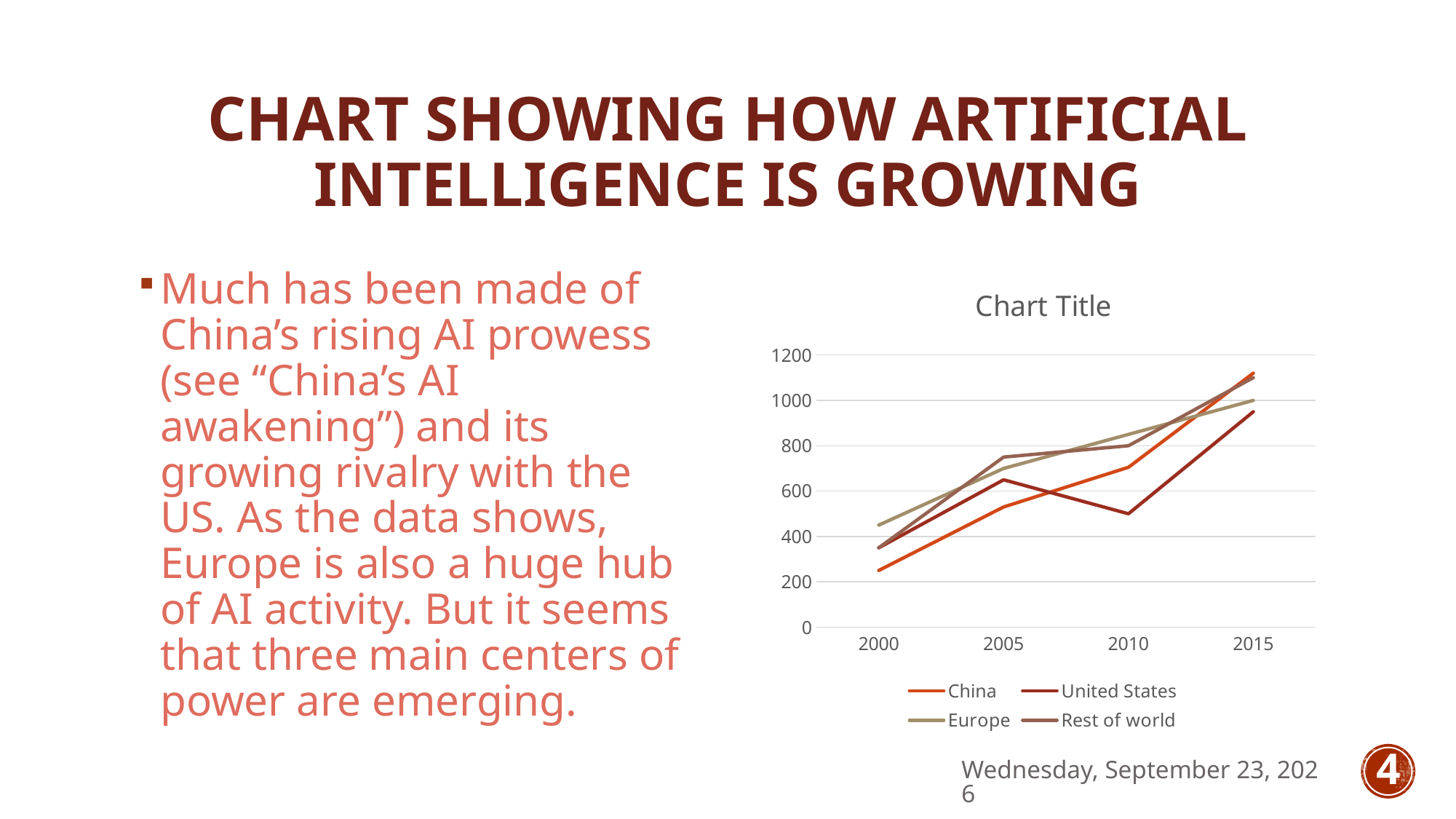
How many series does the chart's legend list? 4 Which series has the lowest value in 2010? United States Is the value for China in 2000 greater or less than 400? less Is the value for United States in 2010 greater or less than 600? less What kind of chart is shown on the slide? line chart In 2000, which is larger: the value for China or the value for United States? United States What is the title printed above the chart? Chart Title Is the value for China in 2015 greater or less than 1000? greater Which series has the lowest value in 2000? China How many years are shown along the x axis of the chart? 4 Does the China line rise or fall from 2000 to 2015? rise